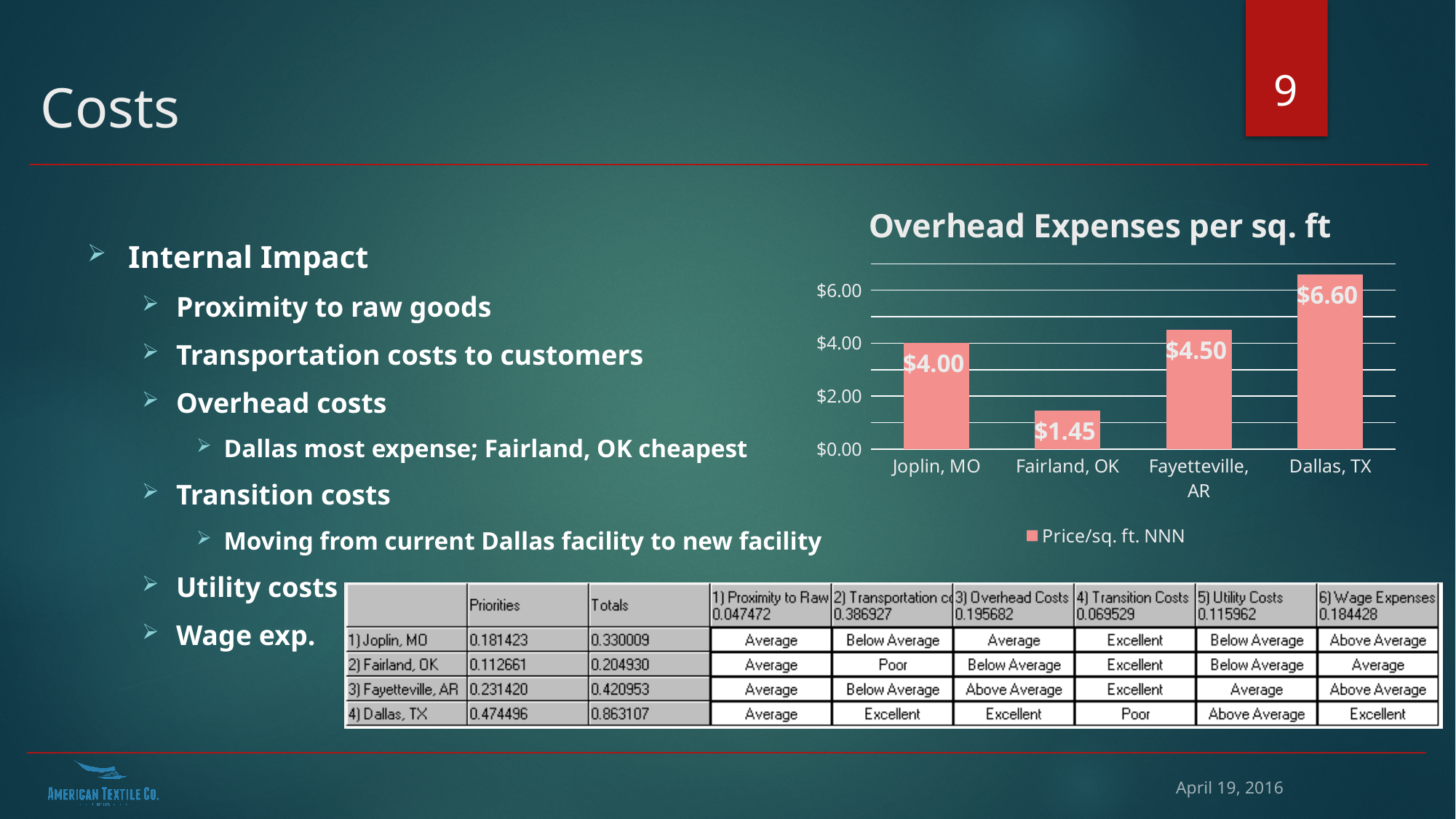
What is the overhead expense per sq. ft for Fairland, OK? $1.45 What type of chart is used to show Overhead Expenses per sq. ft? Bar chart Which location has the lowest overhead expense per sq. ft? Fairland, OK Which has a higher overhead expense per sq. ft, Joplin, MO or Fayetteville, AR? Fayetteville, AR What series name does the legend of the Overhead Expenses per sq. ft chart show? Price/sq. ft. NNN How many locations are shown in the Overhead Expenses per sq. ft chart? 4 What is the overhead expense per sq. ft for Fayetteville, AR? $4.50 What is the difference in overhead expense per sq. ft between Dallas, TX and Fairland, OK? $5.15 What is the overhead expense per sq. ft for Joplin, MO? $4.00 Is the overhead expense per sq. ft for Dallas, TX greater or less than $6.00? greater What is the overhead expense per sq. ft for Dallas, TX? $6.60 Which location has the highest overhead expense per sq. ft? Dallas, TX